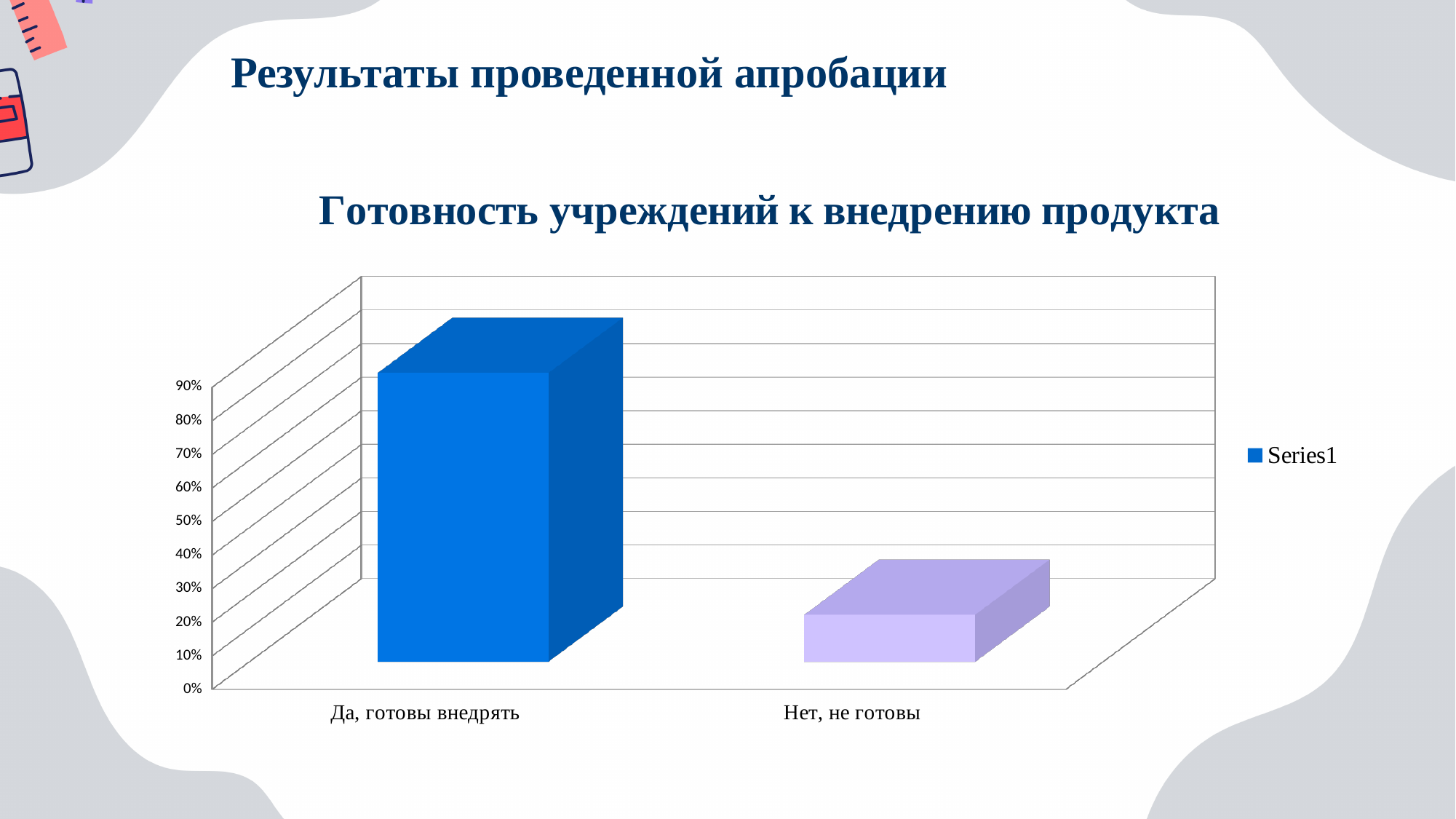
What kind of chart is shown on the slide? bar chart How many series does the chart legend list? 1 Is the value for "Да, готовы внедрять" greater or less than 70%? greater What is the name of the series shown in the legend? Series1 Is the value for "Да, готовы внедрять" greater or less than 50%? greater Is the value for "Нет, не готовы" greater or less than 50%? less What is the title of the chart? Готовность учреждений к внедрению продукта Do the values rise or fall from left to right along the x axis? fall Which category has the lowest value? Нет, не готовы Which is larger: the value for "Да, готовы внедрять" or the value for "Нет, не готовы"? Да, готовы внедрять Which category has the highest value? Да, готовы внедрять How many categories are shown on the x axis of the chart? 2